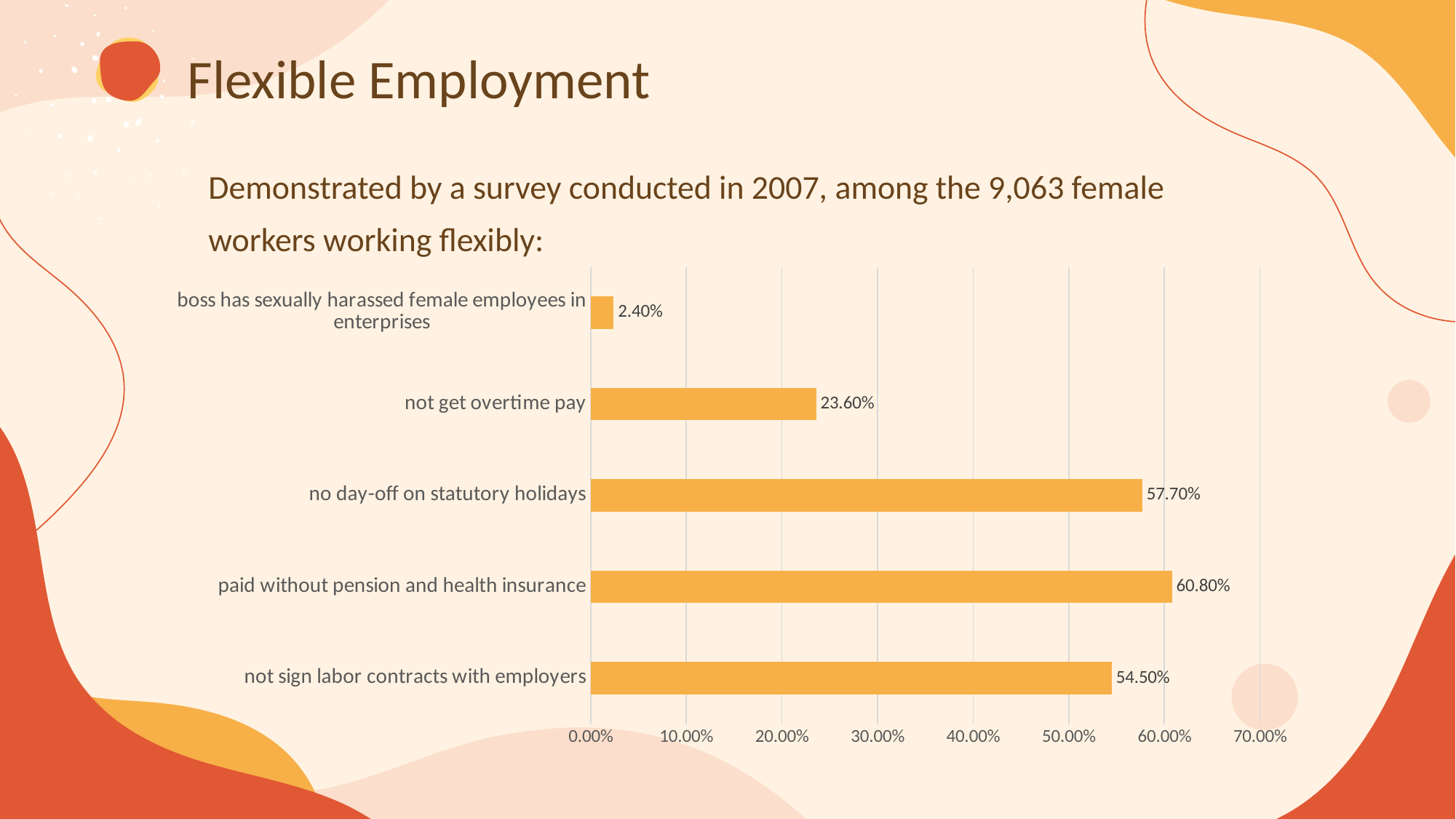
What is the value for 'not get overtime pay'? 23.60% Which is larger: 'no day-off on statutory holidays' or 'not sign labor contracts with employers'? no day-off on statutory holidays Which category has the lowest value? boss has sexually harassed female employees in enterprises Is the value for 'not get overtime pay' greater or less than 30.00%? less What percentage reported that the boss has sexually harassed female employees in enterprises? 2.40% What percentage of surveyed female workers did not sign labor contracts with employers? 54.50% What is the difference between 'no day-off on statutory holidays' and 'not get overtime pay'? 34.10% Which category has the highest value? paid without pension and health insurance What is the maximum value shown on the horizontal axis? 70.00% What is the value for 'paid without pension and health insurance'? 60.80% How many categories are shown in the chart? 5 What kind of chart is shown on the slide? bar chart